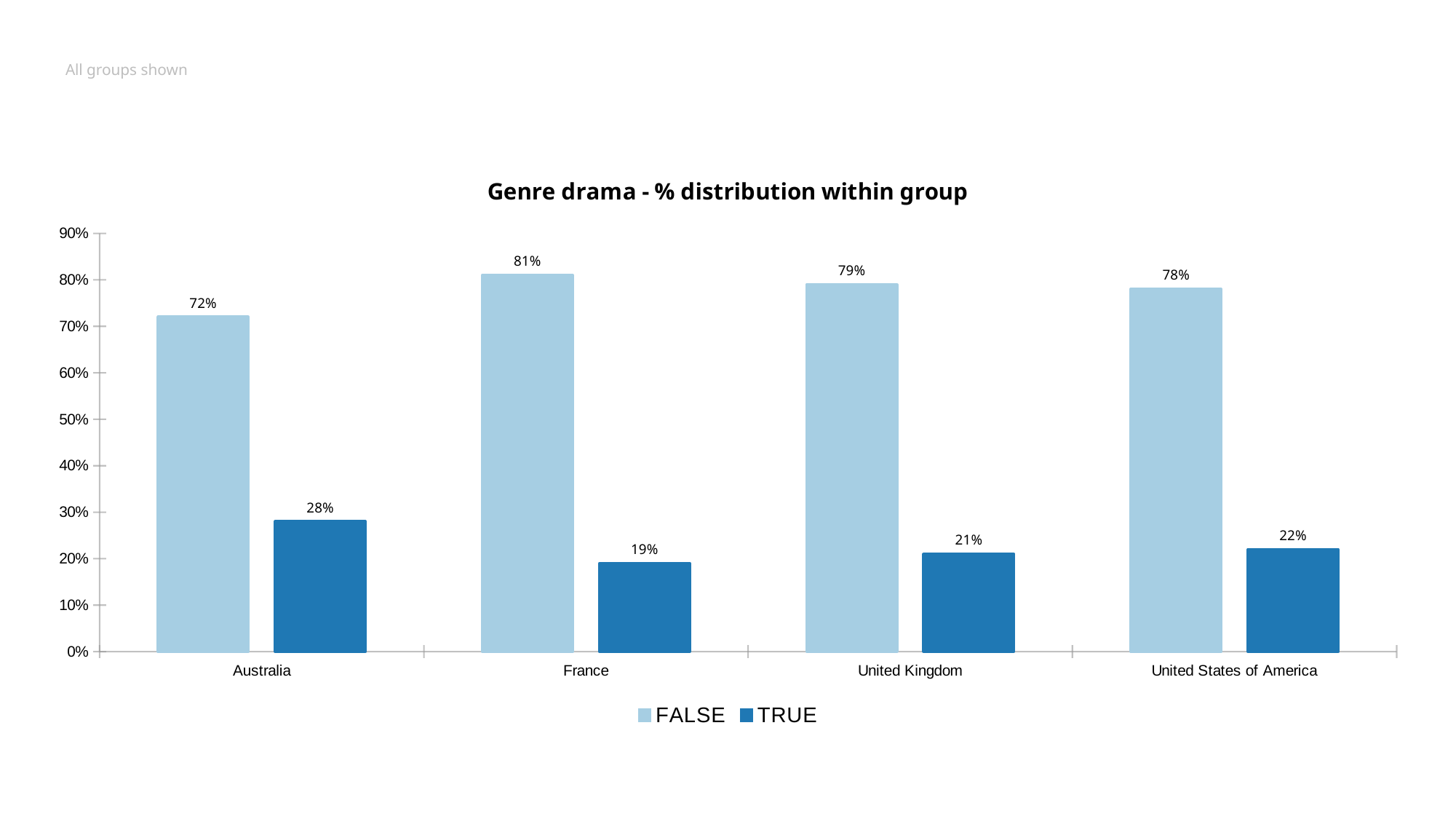
What kind of chart is shown? Bar chart What is the title of the chart? Genre drama - % distribution within group What is the difference between the FALSE and TRUE values for United Kingdom? 58% How many countries are shown on the x axis? 4 Which country has the highest FALSE value? France What is the TRUE value for United States of America? 22% Which country has the highest TRUE value? Australia Which country has the lowest TRUE value? France What is the TRUE value for France? 19% How many series does the legend list? 2 What is the FALSE value for Australia? 72% Which is larger: the TRUE value for Australia or the TRUE value for United Kingdom? Australia